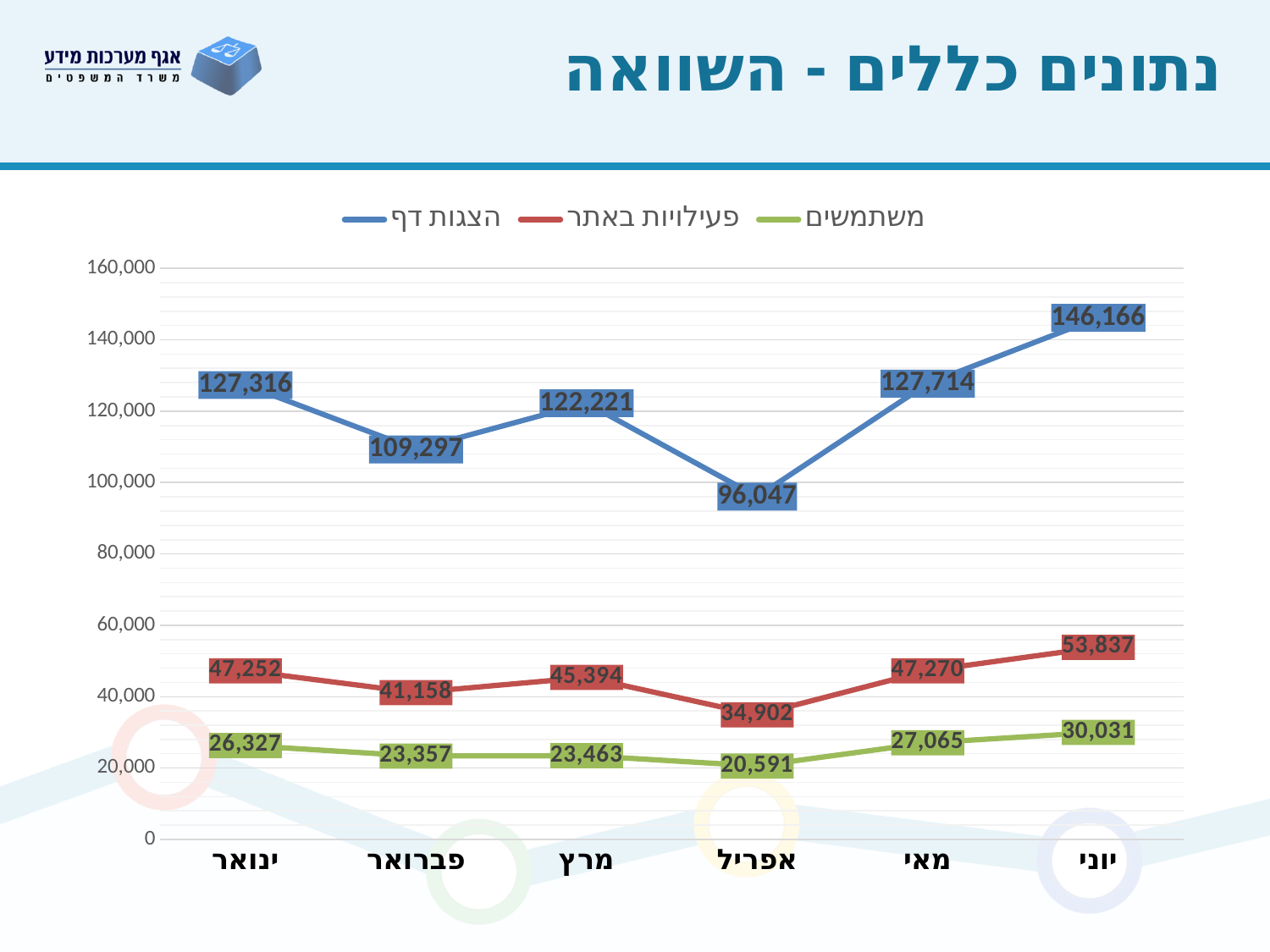
What is the difference between הצגות דף in יוני and in מאי? 18,452 What is the value of משתמשים for ינואר? 26,327 What is the value of הצגות דף for יוני? 146,166 In which month is הצגות דף lowest? אפריל What kind of chart is shown on the slide? line chart How many series does the legend list? 3 How many months are shown on the x axis? 6 Which is larger: משתמשים in פברואר or in מרץ? מרץ What is the value of פעילויות באתר for אפריל? 34,902 In which month is פעילויות באתר highest? יוני Which colour is used for the משתמשים series? green Is the value of הצגות דף for מרץ greater or less than 120,000? greater